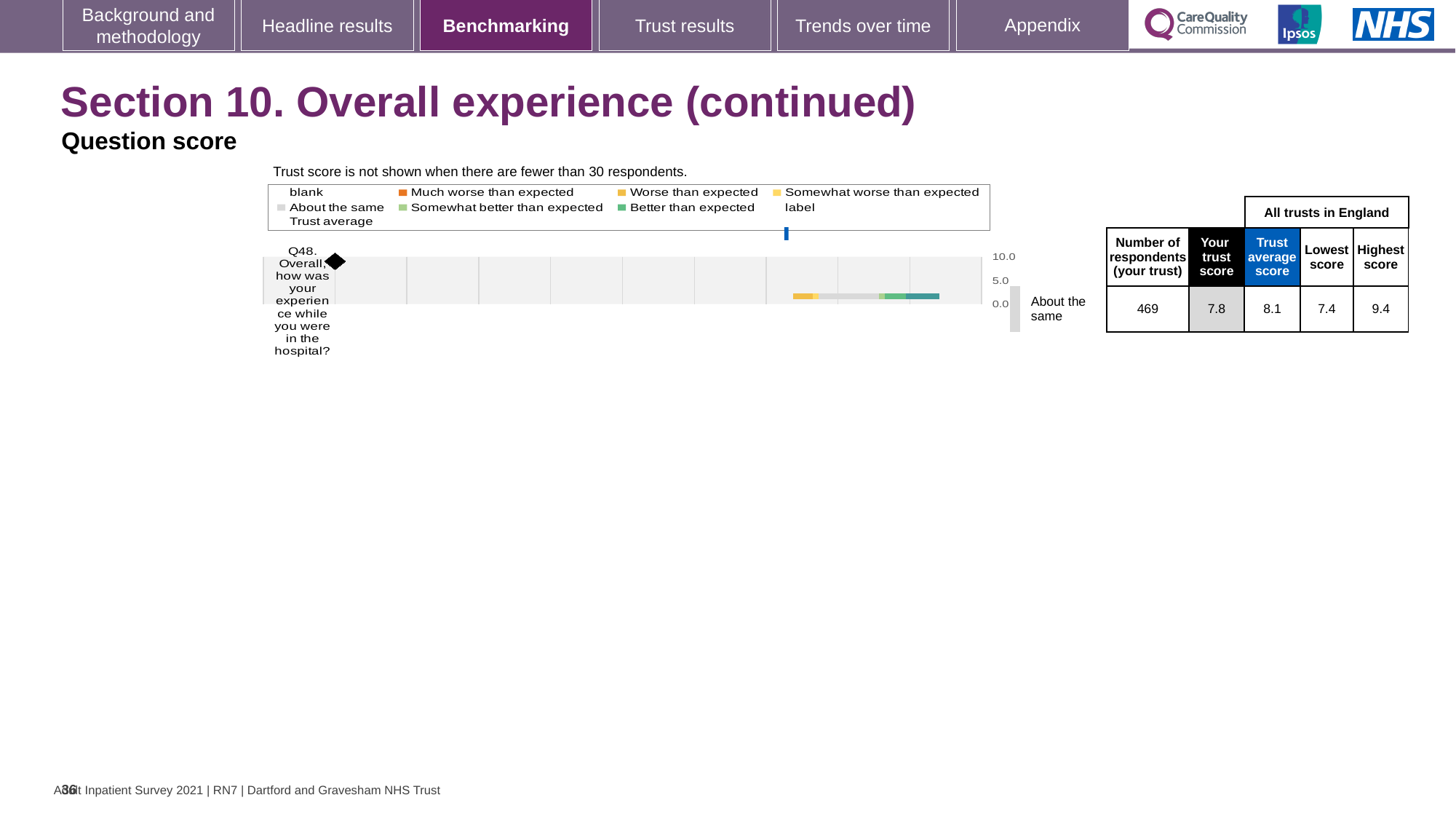
What is the highest score among all trusts in England for Q48? 9.4 What is the difference between the highest score and the lowest score for Q48 across all trusts in England? 2.0 Which is larger for Q48: your trust score or the trust average score? Trust average score How many questions are plotted on the chart? 1 How many respondents from your trust answered Q48? 469 What is the trust score for Q48 shown in the table? 7.8 What kind of chart is used to show the Q48 benchmarking result? Bar chart How is your trust's result for Q48 categorised relative to expectations? About the same What is the trust average score for all trusts in England for Q48? 8.1 What is the lowest score among all trusts in England for Q48? 7.4 Which legend entry is shown with a dark green colour? Better than expected What is the difference between the trust average score and your trust score for Q48? 0.3